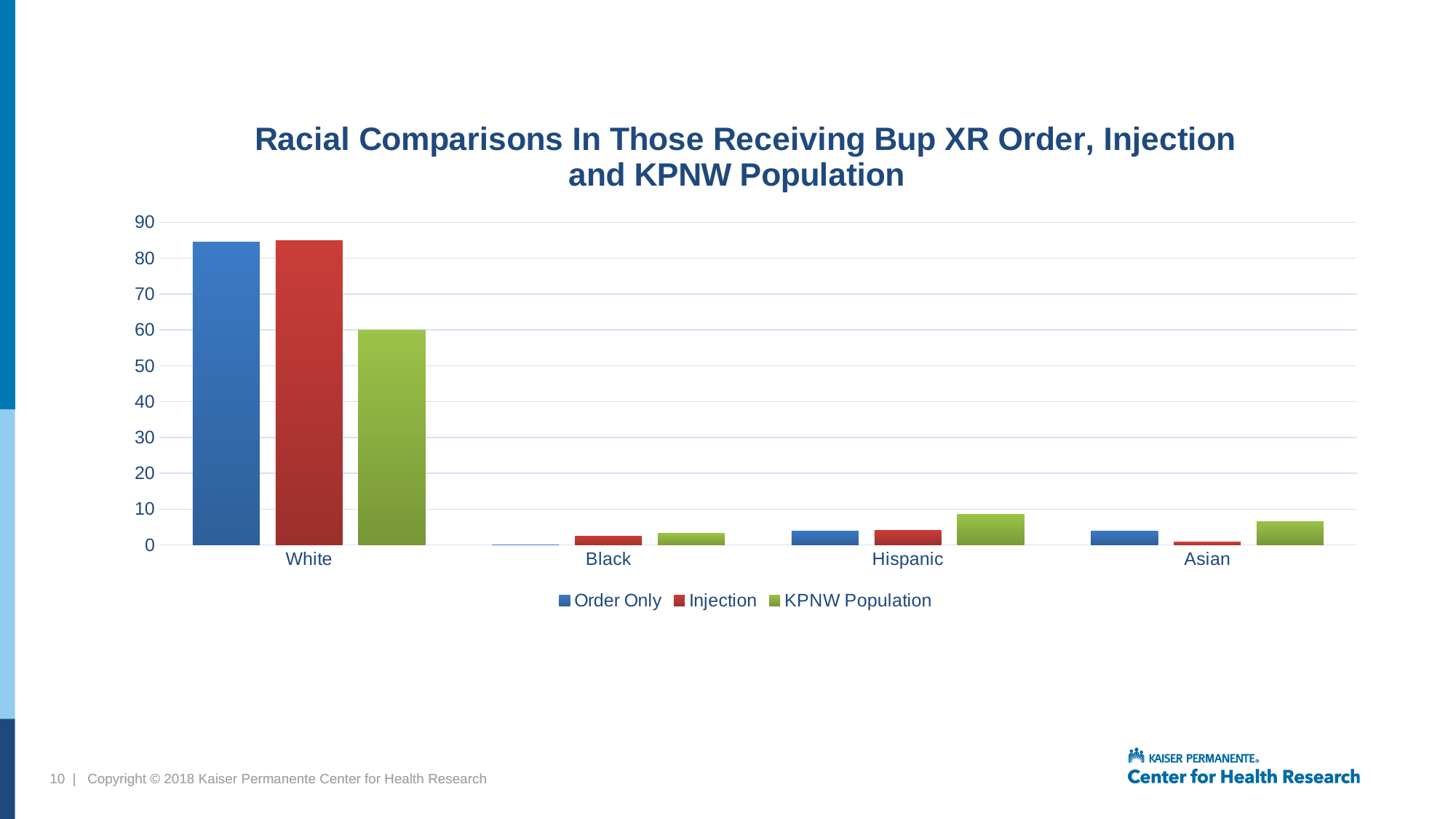
Which category has the lowest Injection value? Asian For Asian, which is larger: the Order Only value or the Injection value? Order Only Which category has the highest Order Only value? White How many series does the legend list? 3 Which series is shown in green in the legend? KPNW Population How many racial categories are shown on the x axis? 4 Is the Injection value for White greater or less than 80? greater Is the KPNW Population value for Hispanic greater or less than 10? less For White, which is larger: the Injection value or the KPNW Population value? Injection Which category has the lowest Order Only value? Black Is the Order Only value for White greater or less than 90? less What kind of chart is shown on the slide? bar chart